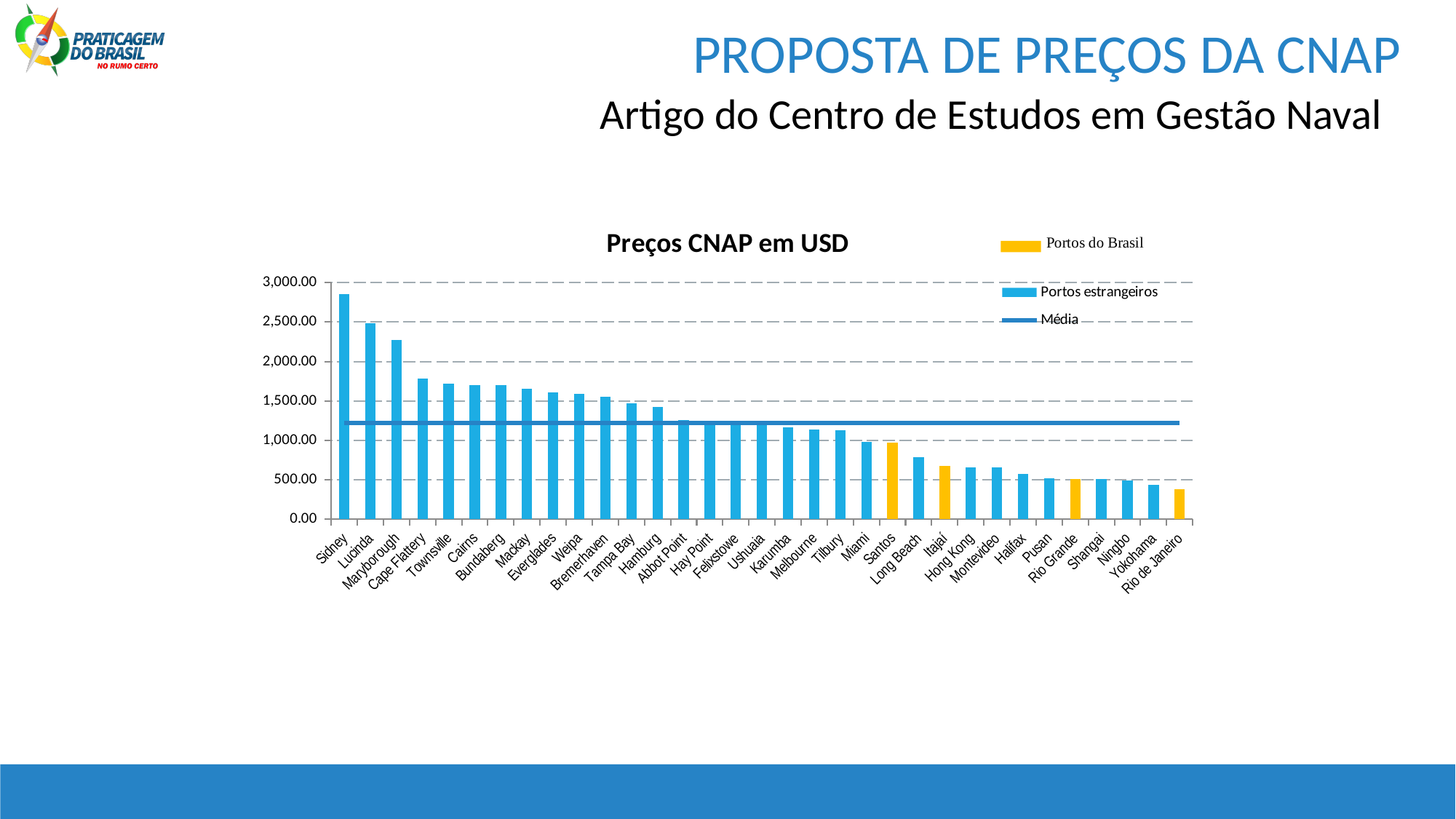
How many ports are shown on the x axis of the chart? 33 Do the bar values rise or fall from left to right along the x axis? Fall Which port has the highest value in the chart? Sidney Is the value for Rio de Janeiro greater or less than 500.00? less Is the value for Long Beach greater or less than 1,000.00? less What kind of chart is shown on the slide? Combination bar and line chart Which has a larger value, Santos or Itajaí? Santos Which port has the lowest value in the chart? Rio de Janeiro Is the value for Maryborough greater or less than 2,000.00? greater What is the title of the chart? Preços CNAP em USD How many entries does the chart legend list? 3